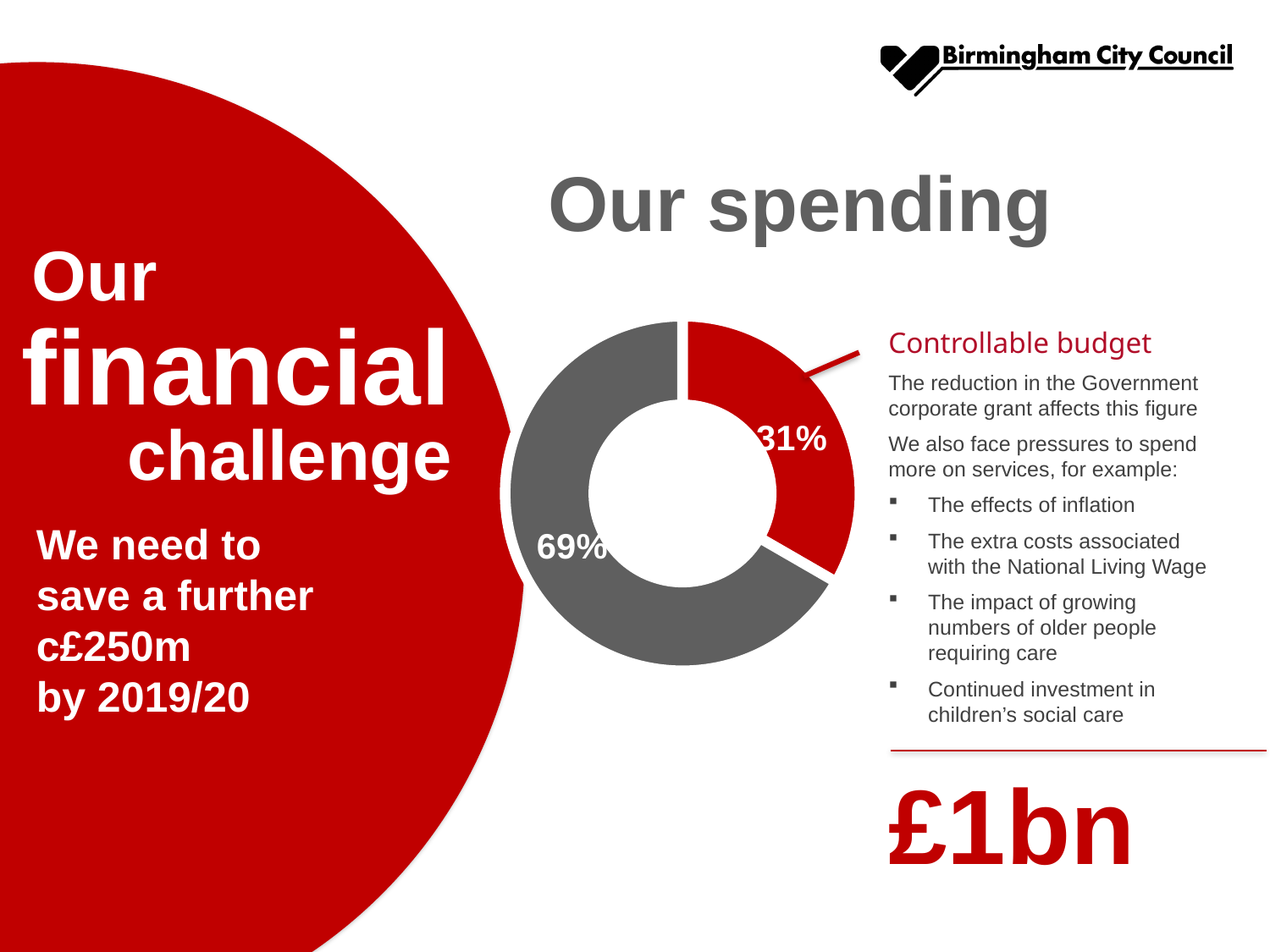
Which slice of the pie chart is the largest? The grey slice (69%) What percentage is shown for the red slice of the pie chart? 31% What is the difference in percentage points between the grey slice and the red slice? 38 What is the total of the two slice percentages shown on the pie chart? 100% What colour is the slice labelled as the Controllable budget? Red What percentage is shown for the grey slice of the pie chart? 69% Which slice of the pie chart is the smallest? The red slice (31%) What is the title of the chart on the slide? Our spending What kind of chart is shown on the slide? Pie chart (donut) Is the red slice or the grey slice larger? The grey slice How many slices does the pie chart have? 2 What share of the pie does the Controllable budget slice represent? 31%